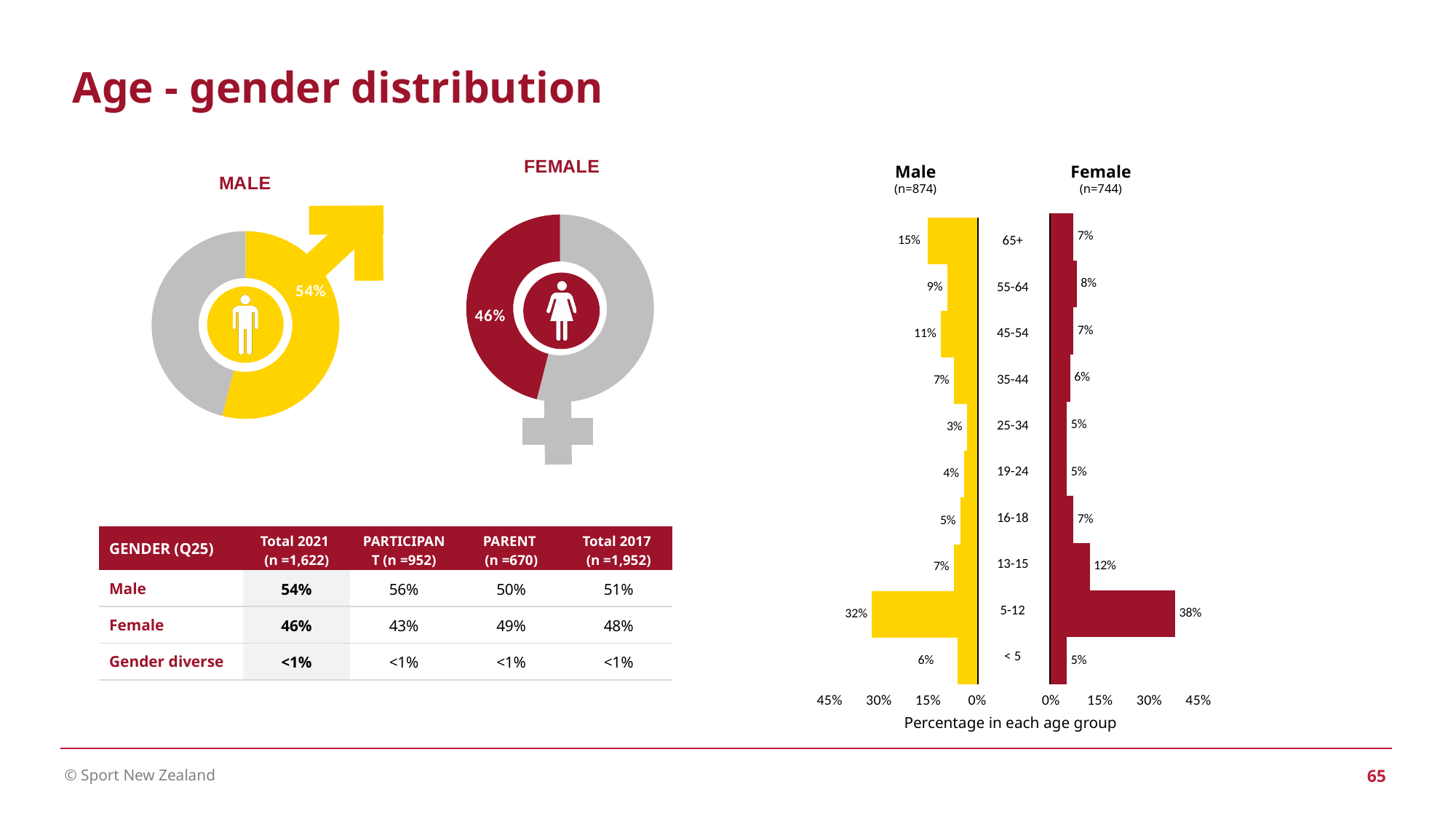
In the age-group bar chart on the right, which age group has the lowest percentage of males? 25-34 In the FEMALE donut chart on the left, what share is shown for females? 46% How many age groups are shown in the age-group bar chart on the right? 10 What is the axis title printed below the age-group bar chart on the right? Percentage in each age group What kind of chart is the age-group chart on the right of the slide? Bar chart In the age-group bar chart on the right, is the 65+ percentage larger for males or females? Male In the age-group bar chart on the right, how many percentage points higher is the female 5-12 value than the male 5-12 value? 6 percentage points In the age-group bar chart on the right, what percentage of males are aged 65+? 15% In the age-group bar chart on the right, which age group has the highest percentage of females? 5-12 In the MALE donut chart on the left, what share is shown for males? 54% In the age-group bar chart on the right, what percentage of males are in the 5-12 age group? 32% In the age-group bar chart on the right, what percentage of females are in the 13-15 age group? 12%